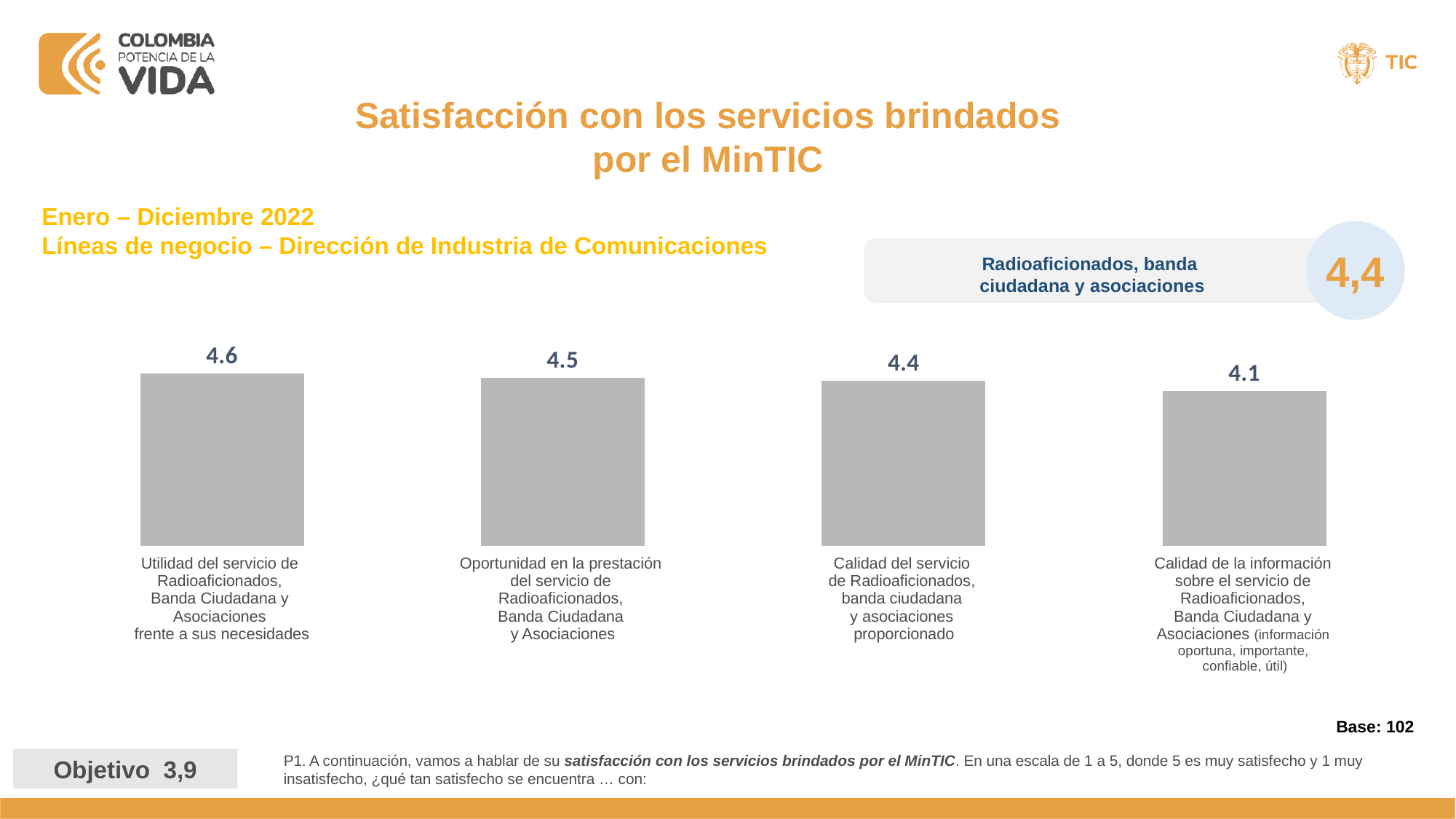
What is the value for 'Calidad del servicio de Radioaficionados, banda ciudadana y asociaciones proporcionado'? 4.4 What kind of chart is shown on the slide? Bar chart Which category has the highest value? Utilidad del servicio de Radioaficionados, Banda Ciudadana y Asociaciones frente a sus necesidades Do the values rise or fall from left to right across the chart? Fall What overall score is shown in the circle next to 'Radioaficionados, banda ciudadana y asociaciones'? 4,4 What is the value for 'Calidad de la información sobre el servicio de Radioaficionados, Banda Ciudadana y Asociaciones'? 4.1 Which category has the lowest value? Calidad de la información sobre el servicio de Radioaficionados, Banda Ciudadana y Asociaciones Which is larger: the value for 'Oportunidad en la prestación del servicio' or the value for 'Calidad del servicio proporcionado'? Oportunidad en la prestación del servicio How many categories are shown in the chart? 4 What is the difference between the value for 'Utilidad del servicio' and the value for 'Calidad de la información'? 0.5 What is the value for 'Utilidad del servicio de Radioaficionados, Banda Ciudadana y Asociaciones frente a sus necesidades'? 4.6 What is the value for 'Oportunidad en la prestación del servicio de Radioaficionados, Banda Ciudadana y Asociaciones'? 4.5